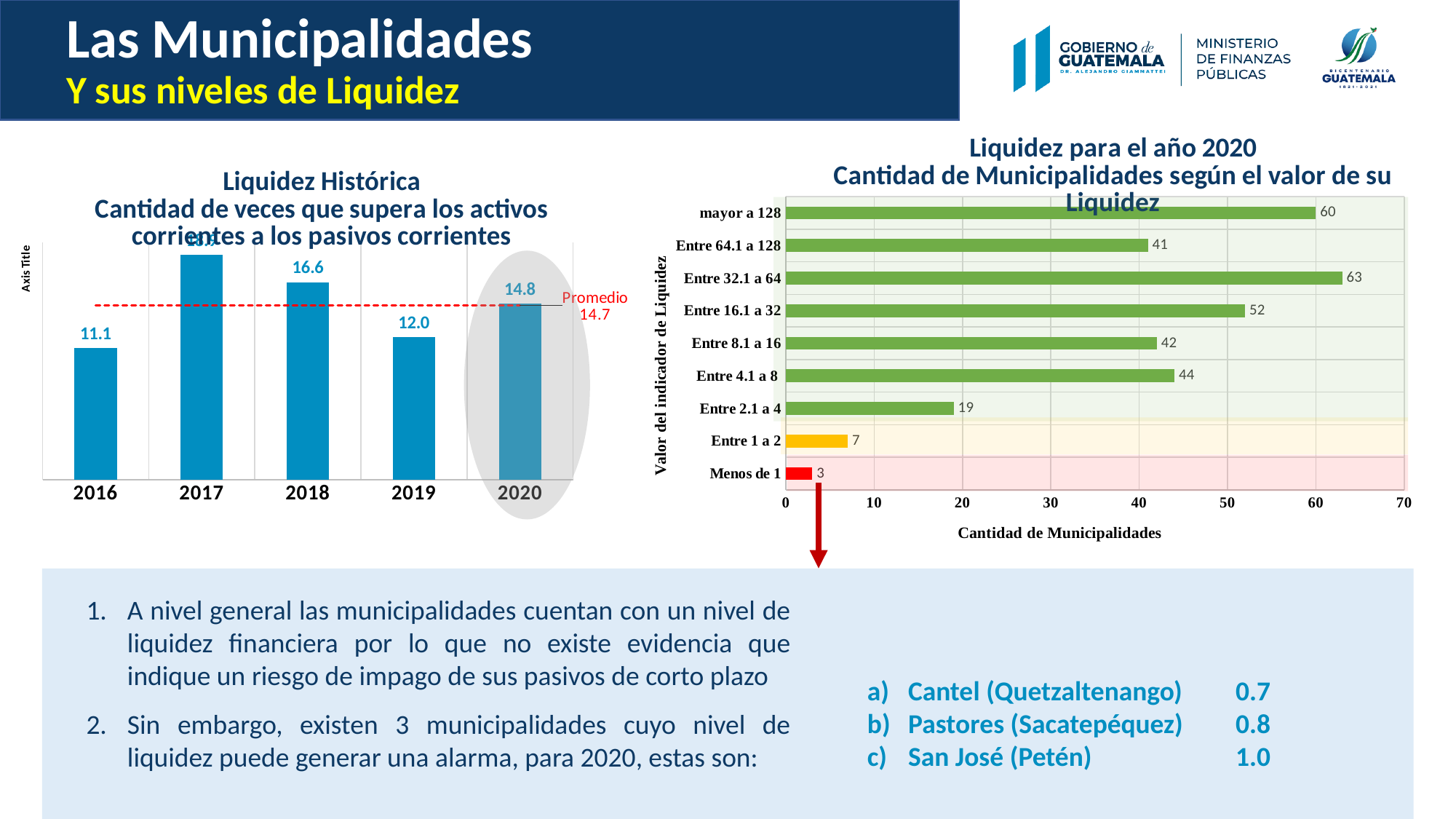
In the 'Liquidez Histórica' chart, what is the value for 2016? 11.1 In the 'Liquidez para el año 2020' chart, how many municipalities are in the 'mayor a 128' category? 60 In the 'Liquidez Histórica' chart, which year has the highest bar? 2017 In the 'Liquidez Histórica' chart, which year has the lowest value? 2016 In the 'Liquidez para el año 2020' chart, which has more municipalities: 'Entre 8.1 a 16' or 'Entre 4.1 a 8'? Entre 4.1 a 8 In the 'Liquidez Histórica' chart, what is the difference between the 2018 and 2019 values? 4.6 In the 'Liquidez para el año 2020' chart, which category has the lowest number of municipalities? Menos de 1 In the 'Liquidez Histórica' chart, what is the value for 2020? 14.8 What type of chart is 'Liquidez para el año 2020'? Bar chart In the 'Liquidez Histórica' chart, what is the value of the 'Promedio' line? 14.7 In the 'Liquidez para el año 2020' chart, how many categories are shown on the vertical axis? 9 In the 'Liquidez para el año 2020' chart, which category has the highest number of municipalities? Entre 32.1 a 64